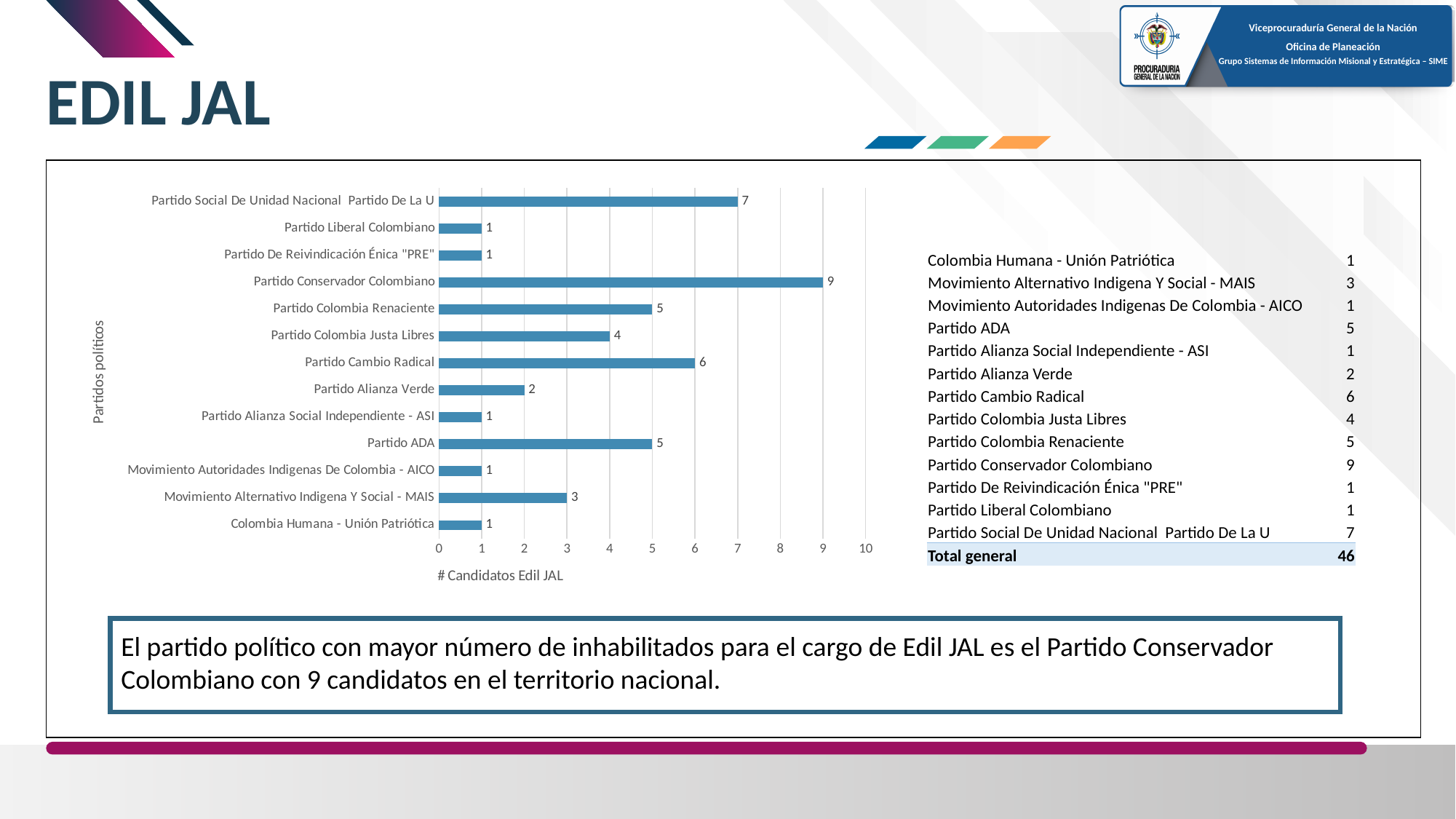
What is the value for Partido Alianza Verde? 2 How many parties are shown in the chart? 13 Which is larger, Partido Colombia Renaciente or Partido Colombia Justa Libres? Partido Colombia Renaciente What kind of chart is shown? Bar chart What is the label of the horizontal axis? # Candidatos Edil JAL What is the total number of candidates across all parties? 46 What is the label of the vertical axis? Partidos políticos What is the value for Partido Cambio Radical? 6 Which party has the highest number of candidates? Partido Conservador Colombiano What is the value for Partido Conservador Colombiano? 9 What is the value for Movimiento Alternativo Indigena Y Social - MAIS? 3 What is the difference between Partido Conservador Colombiano and Partido Social De Unidad Nacional Partido De La U? 2